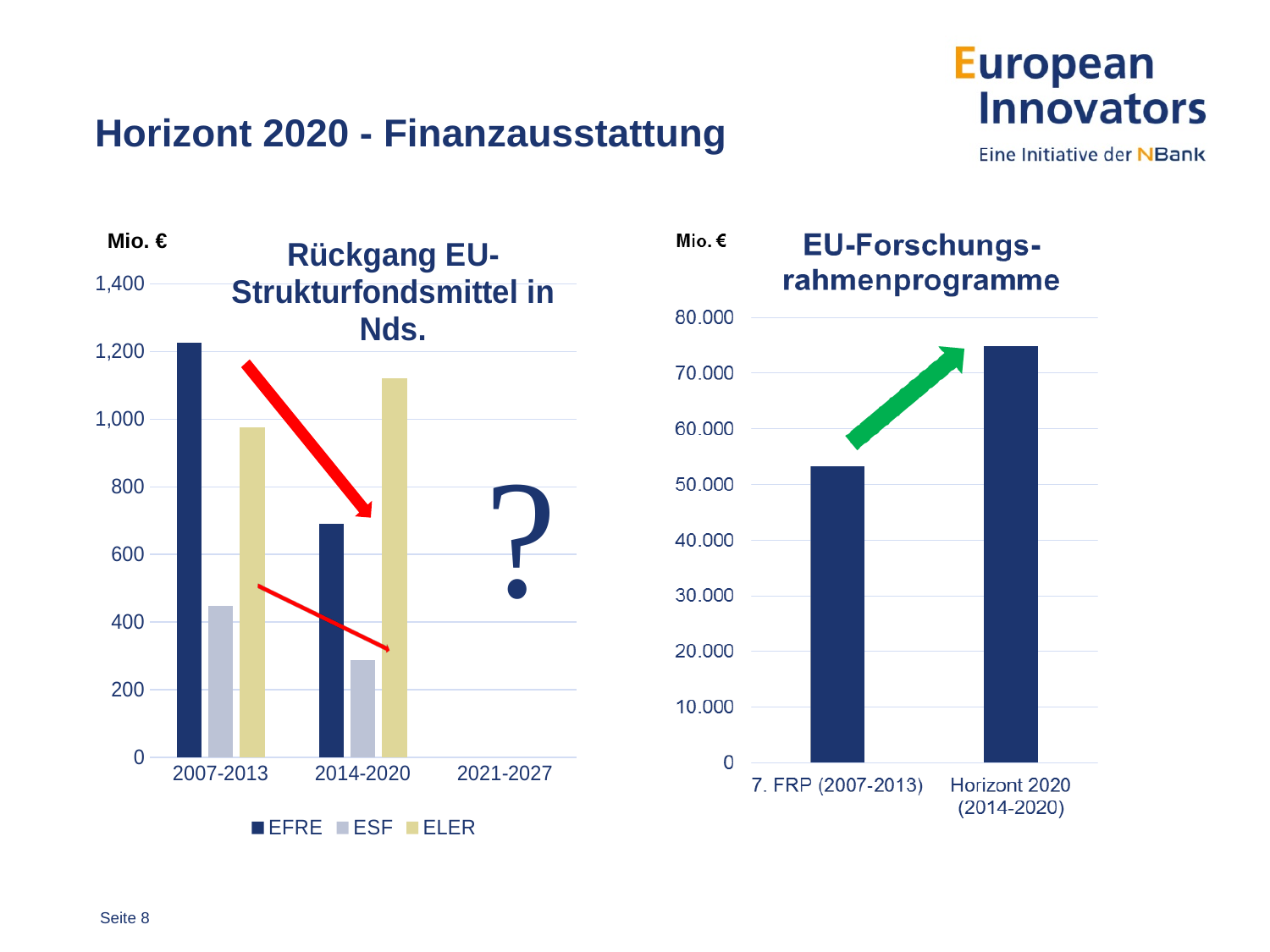
In the 'Rückgang EU-Strukturfondsmittel in Nds.' chart, which series has the highest value for 2014-2020? ELER How many bars are plotted in the 'EU-Forschungsrahmenprogramme' chart? 2 What kind of chart is the 'Rückgang EU-Strukturfondsmittel in Nds.' chart? bar chart How many series does the legend of the 'Rückgang EU-Strukturfondsmittel in Nds.' chart list? 3 In the 'EU-Forschungsrahmenprogramme' chart, is the value for Horizont 2020 (2014-2020) greater or less than 70.000? greater In the 'Rückgang EU-Strukturfondsmittel in Nds.' chart, is the EFRE value larger in 2007-2013 or in 2014-2020? 2007-2013 In the 'Rückgang EU-Strukturfondsmittel in Nds.' chart, is the EFRE value for 2007-2013 greater or less than 1,200? greater In the 'Rückgang EU-Strukturfondsmittel in Nds.' chart, does the ELER value rise or fall from 2007-2013 to 2014-2020? rise In the 'Rückgang EU-Strukturfondsmittel in Nds.' chart, which series has the lowest value for 2007-2013? ESF Which series are listed in the legend of the 'Rückgang EU-Strukturfondsmittel in Nds.' chart? EFRE, ESF, ELER In the 'EU-Forschungsrahmenprogramme' chart, which bar is higher: 7. FRP (2007-2013) or Horizont 2020 (2014-2020)? Horizont 2020 (2014-2020) In the 'Rückgang EU-Strukturfondsmittel in Nds.' chart, is the ESF value for 2014-2020 greater or less than 400? less